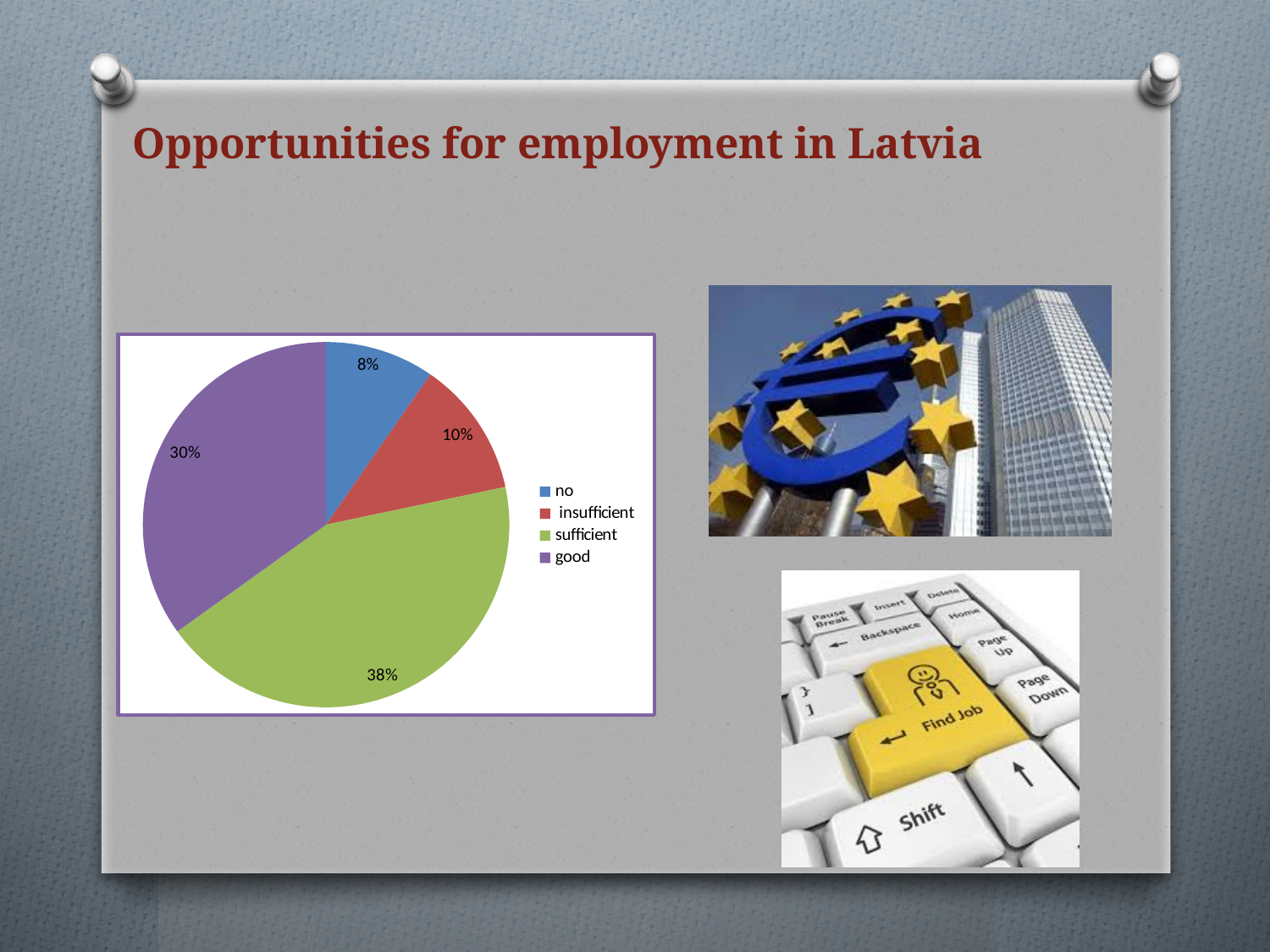
What percentage is shown for the "insufficient" slice of the pie chart? 10% Which is larger in the pie chart, the "insufficient" slice or the "no" slice? insufficient What percentage is shown for the "no" slice of the pie chart? 8% Which category has the smallest slice in the pie chart? no What colour is the "sufficient" slice in the pie chart? green What is the difference between the "insufficient" and "no" percentages in the pie chart? 2% What percentage is shown for the "sufficient" slice of the pie chart? 38% What kind of chart is shown on the slide? pie chart What percentage is shown for the "good" slice of the pie chart? 30% What is the title of the slide containing the pie chart? Opportunities for employment in Latvia How many categories does the pie chart's legend list? 4